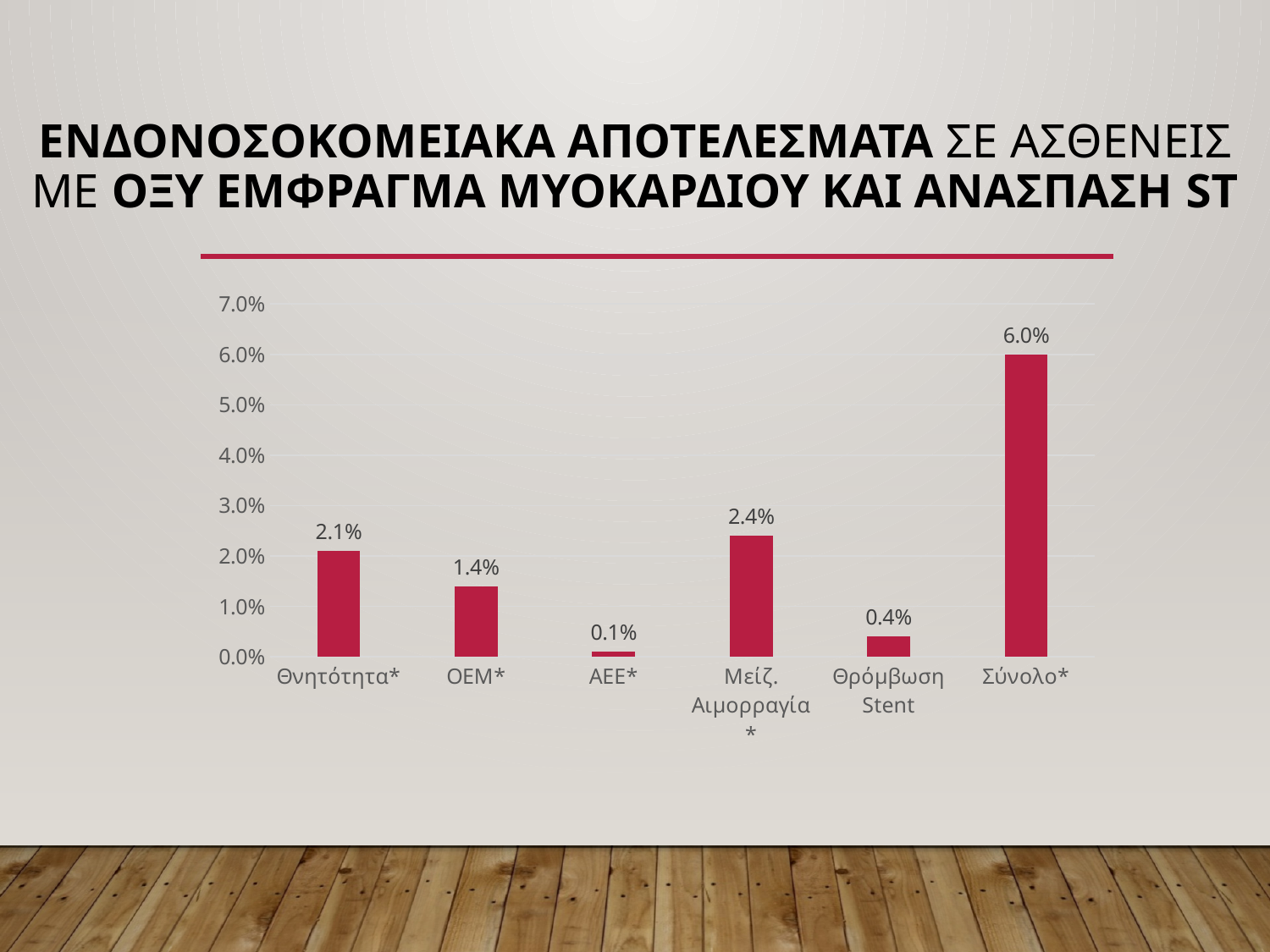
How many categories are shown on the x axis? 6 What is the difference between the values for Σύνολο* and Μείζ. Αιμορραγία*? 3.6% What is the value for Θνητότητα*? 2.1% Which is larger, the value for Θνητότητα* or the value for ΟΕΜ*? Θνητότητα* Is the value for Μείζ. Αιμορραγία* greater or less than 2.0%? greater What is the value for Θρόμβωση Stent? 0.4% What is the value for ΑΕΕ*? 0.1% Which category has the highest value? Σύνολο* What kind of chart is shown on the slide? bar chart Which category has the lowest value? ΑΕΕ* What is the value for ΟΕΜ*? 1.4% What is the highest value shown on the y axis? 7.0%